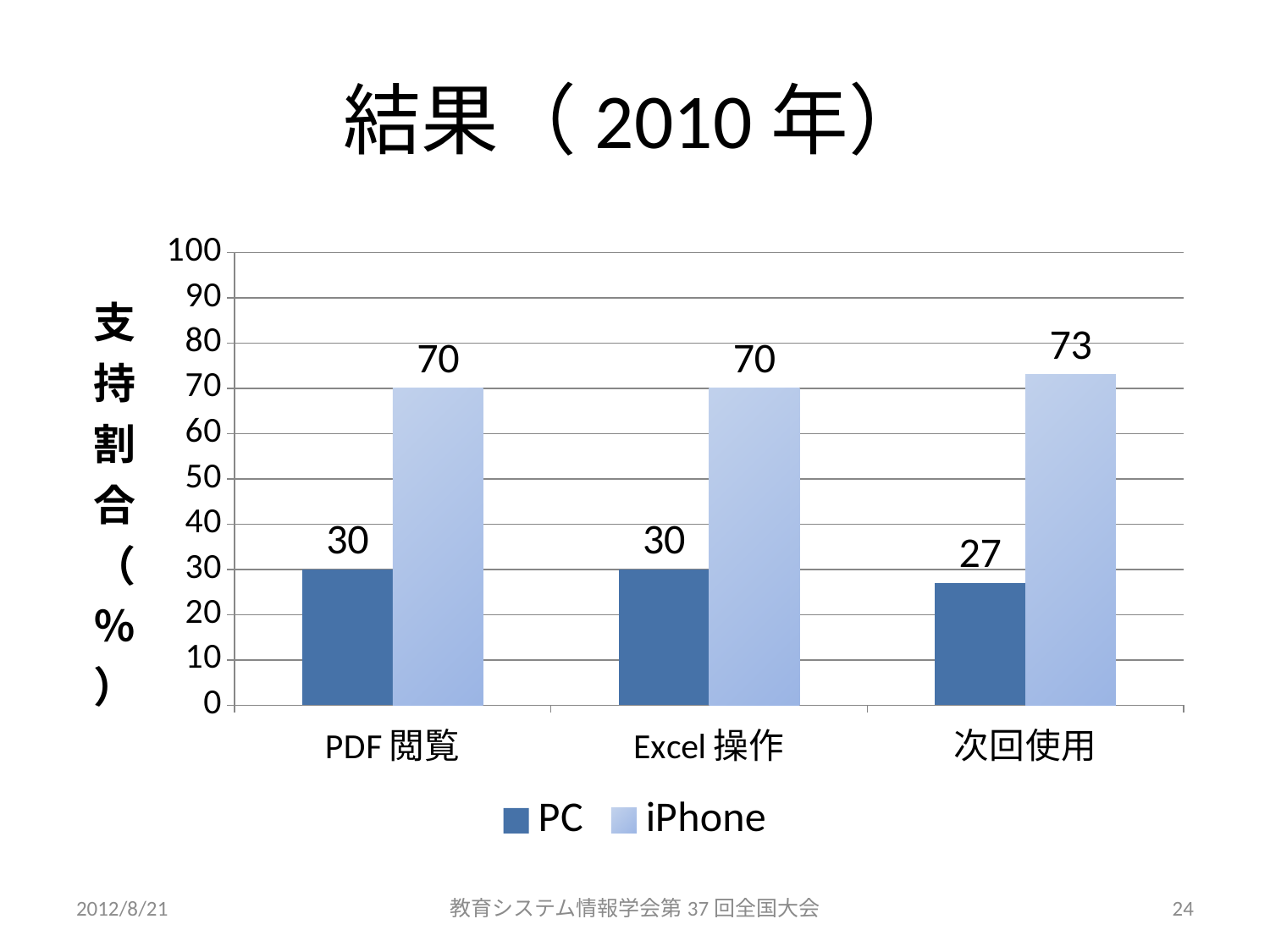
What is the iPhone value for 次回使用? 73 How many series does the legend list? 2 What is the difference between the iPhone and PC values for 次回使用? 46 What kind of chart is shown on the slide? bar chart Which category has the highest iPhone value? 次回使用 What is the PC value for PDF閲覧? 30 How many categories are shown on the x axis? 3 What is the title of the slide? 結果（2010年） What is the iPhone value for Excel操作? 70 Which category has the lowest PC value? 次回使用 What is the PC value for 次回使用? 27 For PDF閲覧, which is larger, the PC value or the iPhone value? iPhone